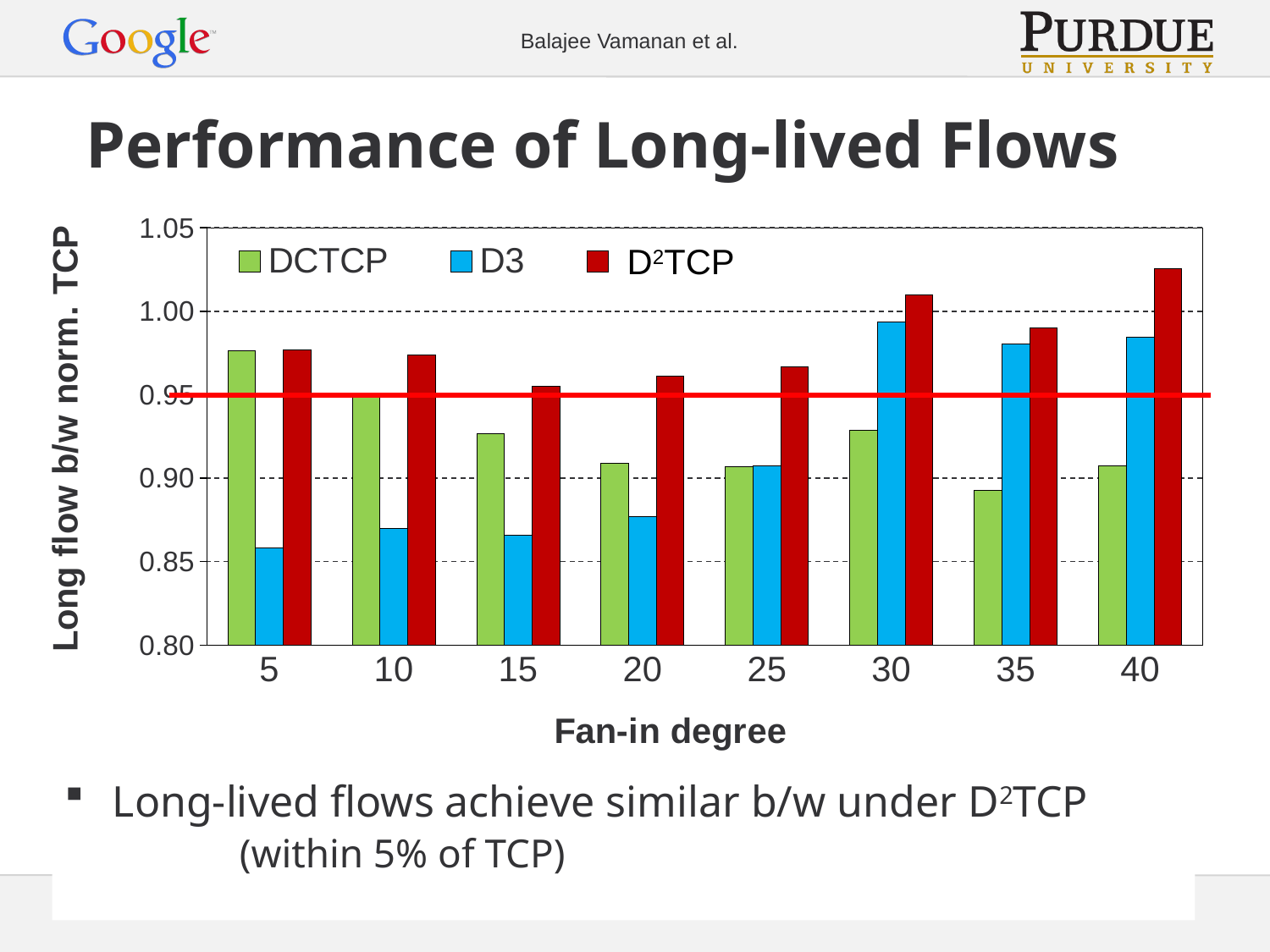
How many fan-in degree categories are plotted on the x axis? 8 What is the label of the x axis? Fan-in degree At fan-in degree 5, which series has the larger value, D3 or D²TCP? D²TCP At which fan-in degree is the D²TCP value highest? 40 Is the D²TCP value at fan-in degree 40 greater or less than 1.00? greater Is the DCTCP value at fan-in degree 5 greater or less than 0.95? greater At which fan-in degree is the D3 value lowest? 5 What kind of chart is shown on the slide? bar chart At fan-in degree 40, which series has the larger value, DCTCP or D²TCP? D²TCP How many series does the chart legend list? 3 Is the D3 value at fan-in degree 5 greater or less than 0.90? less